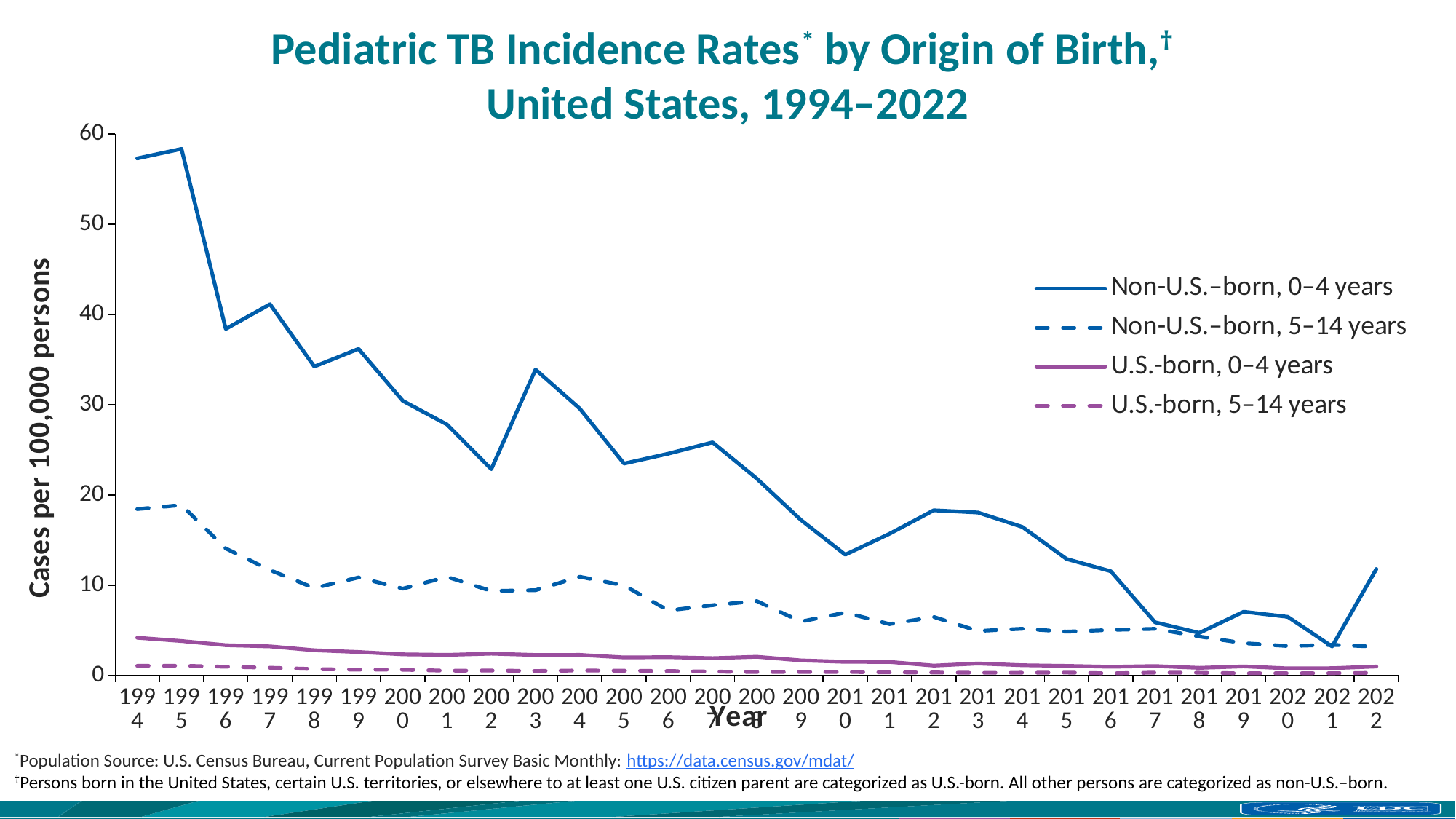
In 1994, which is larger: Non-U.S.–born, 0–4 years or Non-U.S.–born, 5–14 years? Non-U.S.–born, 0–4 years What kind of chart is shown on the slide? line chart Which series has the lowest values across the whole period? U.S.-born, 5–14 years Does the Non-U.S.–born, 0–4 years series generally rise or fall from 1994 to 2021? fall Is the value for Non-U.S.–born, 0–4 years in 1994 greater or less than 50? greater Is the value for U.S.-born, 0–4 years in 1994 greater or less than 10? less Is the value for Non-U.S.–born, 5–14 years in 1994 greater or less than 10? greater Which series has the highest value in 1994? Non-U.S.–born, 0–4 years How many years are plotted along the x axis? 29 What is the label of the y axis? Cases per 100,000 persons How many series does the legend list? 4